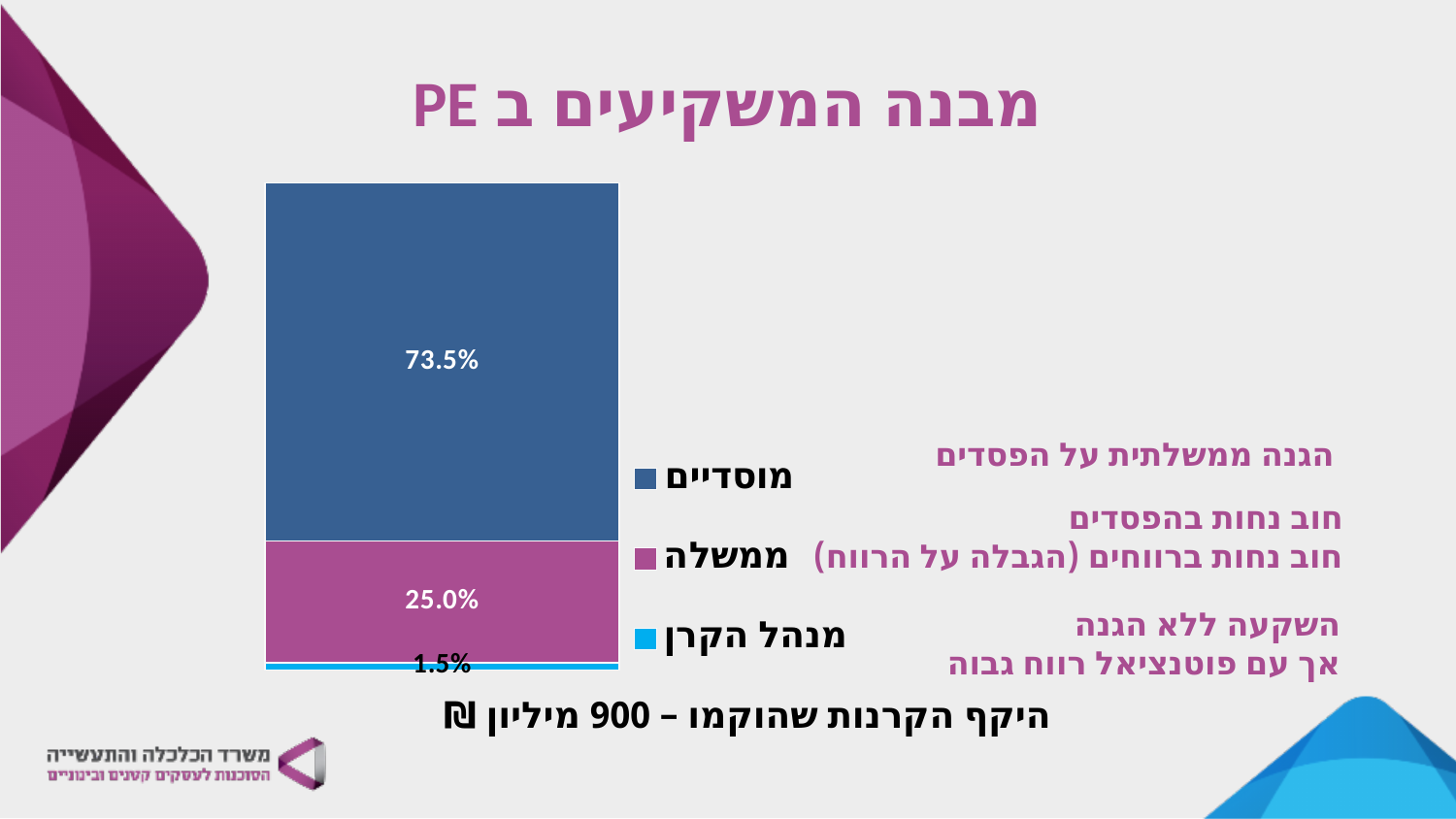
What is the title of the chart on the slide? מבנה המשקיעים ב PE What share of PE investors is attributed to ממשלה (government) in the chart? 25.0% What share of PE investors is attributed to מנהל הקרן (fund manager) in the chart? 1.5% How many series does the chart legend list? 3 What is the total of the three segments in the stacked bar? 100% What is the difference in percentage points between the מוסדיים share and the ממשלה share? 48.5 What is the difference in percentage points between the ממשלה share and the מנהל הקרן share? 23.5 What kind of chart is shown on the slide? Stacked bar chart What share of PE investors is attributed to מוסדיים (institutional investors) in the chart? 73.5% Which investor group has the smallest share in the chart? מנהל הקרן Which is larger, the share for ממשלה or the share for מנהל הקרן? ממשלה Which investor group has the largest share in the chart? מוסדיים